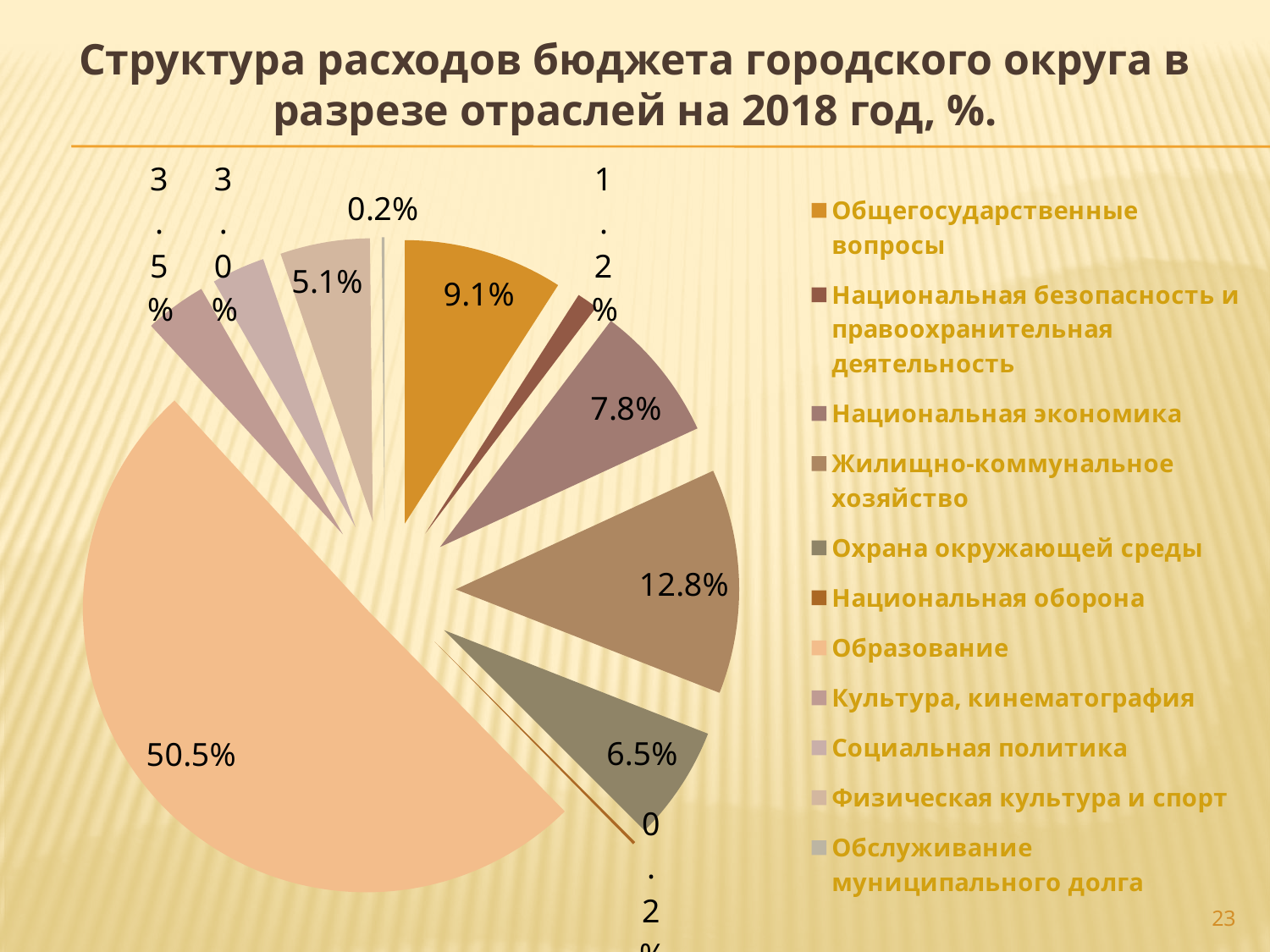
What is the value for Общегосударственные вопросы? 9.1% What kind of chart is shown on the slide? pie chart Which category has the largest share of the pie? Образование What is the value for Охрана окружающей среды? 6.5% What share of the budget expenditure goes to Образование? 50.5% What is the value for Физическая культура и спорт? 5.1% What is the title of the chart? Структура расходов бюджета городского округа в разрезе отраслей на 2018 год, %. What is the value for Жилищно-коммунальное хозяйство? 12.8% What is the difference between the shares of Жилищно-коммунальное хозяйство and Общегосударственные вопросы? 3.7% Which is larger, the share for Национальная экономика or the share for Охрана окружающей среды? Национальная экономика What is the value for Национальная экономика? 7.8% How many categories does the legend list? 11